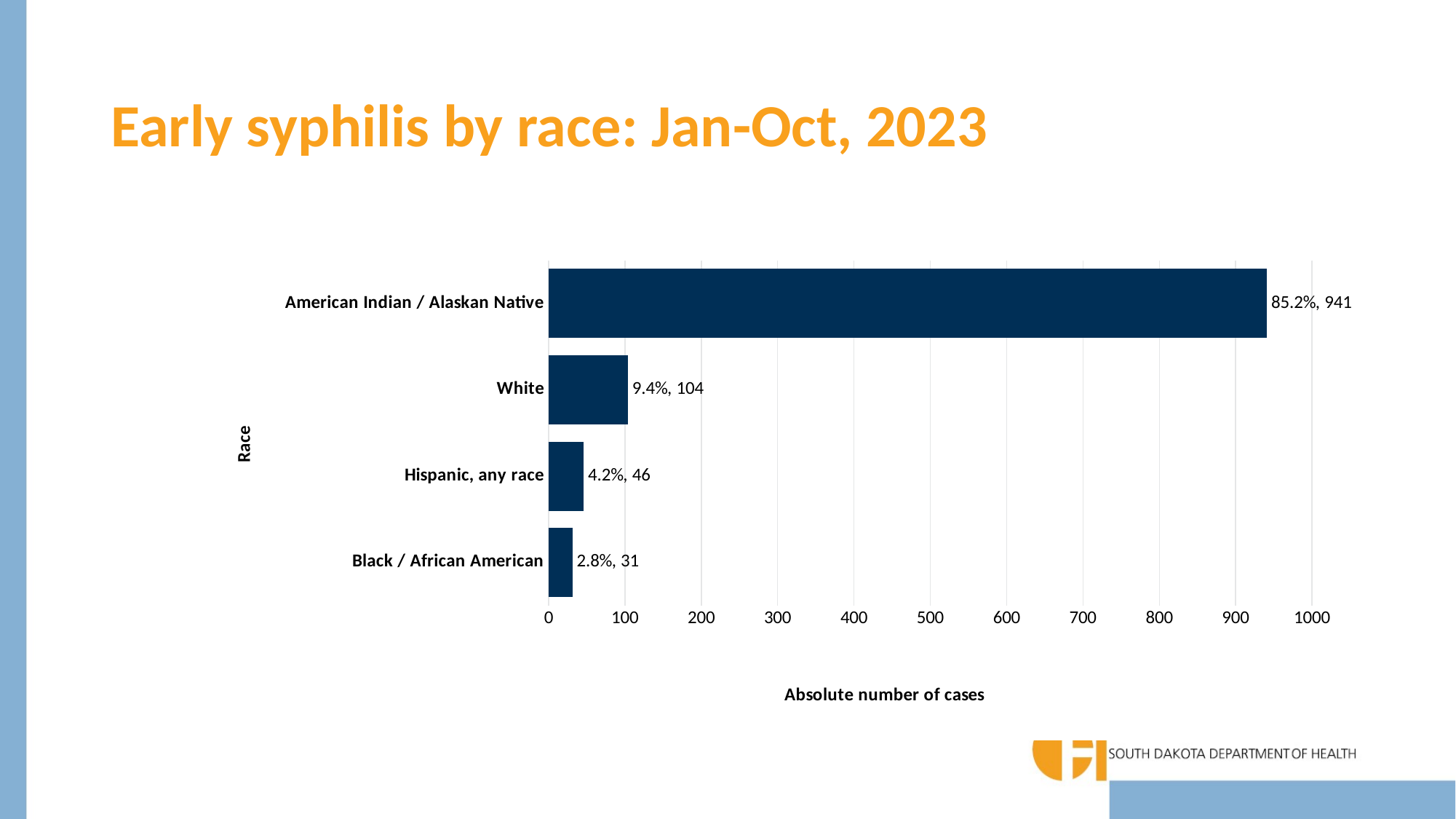
How many race categories are shown in the chart? 4 Is the value for American Indian / Alaskan Native greater or less than 900? greater Which has more cases, Hispanic, any race or Black / African American? Hispanic, any race How many early syphilis cases were reported for American Indian / Alaskan Native? 941 What kind of chart is shown on the slide? bar chart Which race category has the lowest number of cases? Black / African American What is the label of the horizontal axis? Absolute number of cases What percentage is shown for Black / African American? 2.8% What percentage of early syphilis cases is shown for White? 9.4% Which race category has the highest number of cases? American Indian / Alaskan Native How many cases are shown for Hispanic, any race? 46 What is the difference in cases between White and Hispanic, any race? 58